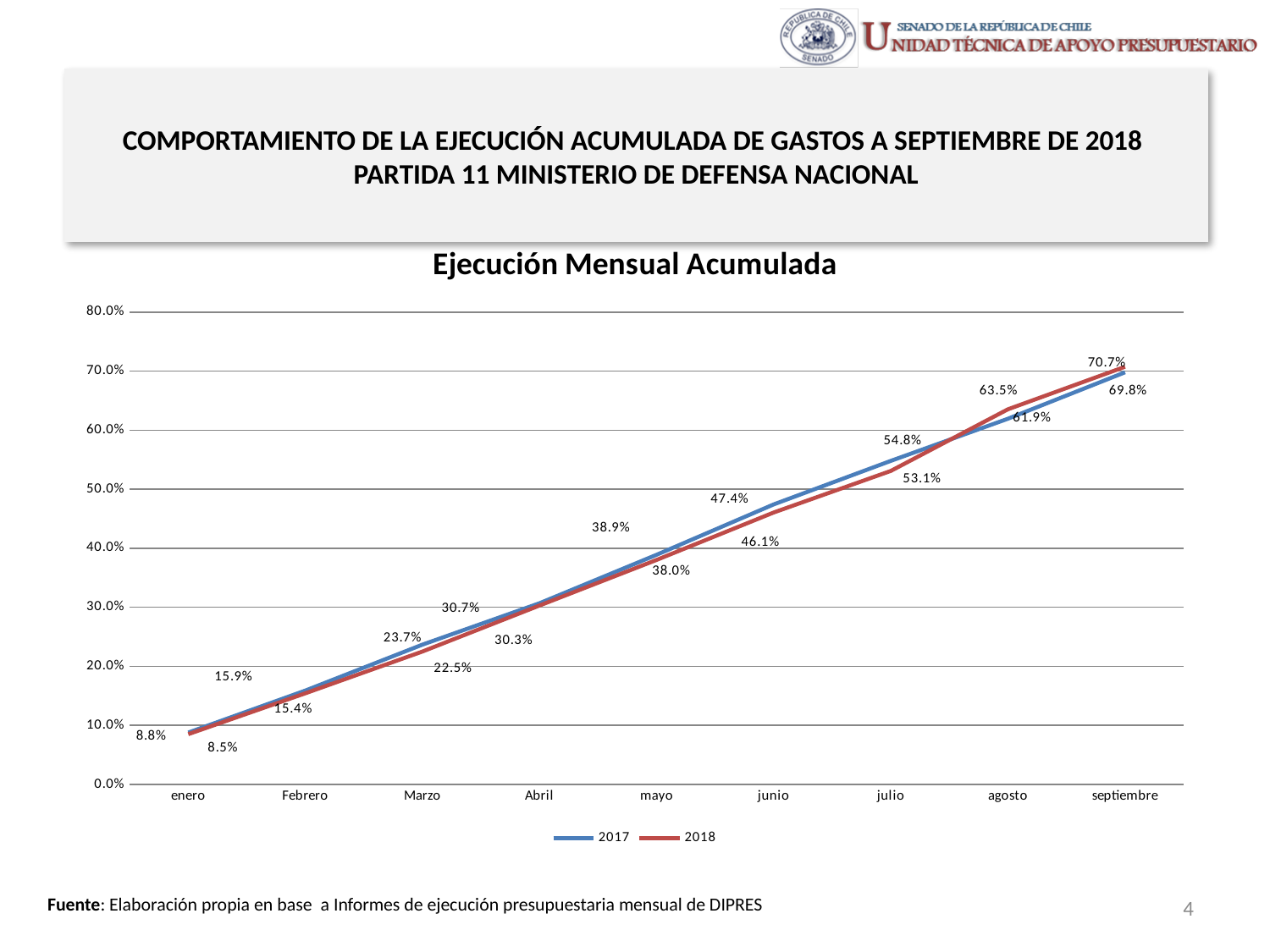
Do the values of the 2018 series rise or fall from enero to septiembre? Rise How many series does the legend of the 'Ejecución Mensual Acumulada' chart list? 2 What is the difference between the 2017 and 2018 values in mayo? 0.9 percentage points What is the value for 2018 in julio? 53.1% What is the value for 2017 in enero? 8.8% What is the title of the chart? Ejecución Mensual Acumulada In julio, which series has the higher value, 2017 or 2018? 2017 What is the value for 2017 in junio? 47.4% In which month does the 2018 series reach its highest value? septiembre How many months are plotted along the x axis of the chart? 9 What kind of chart is shown on the slide? Line chart What is the value for 2018 in Marzo? 22.5%